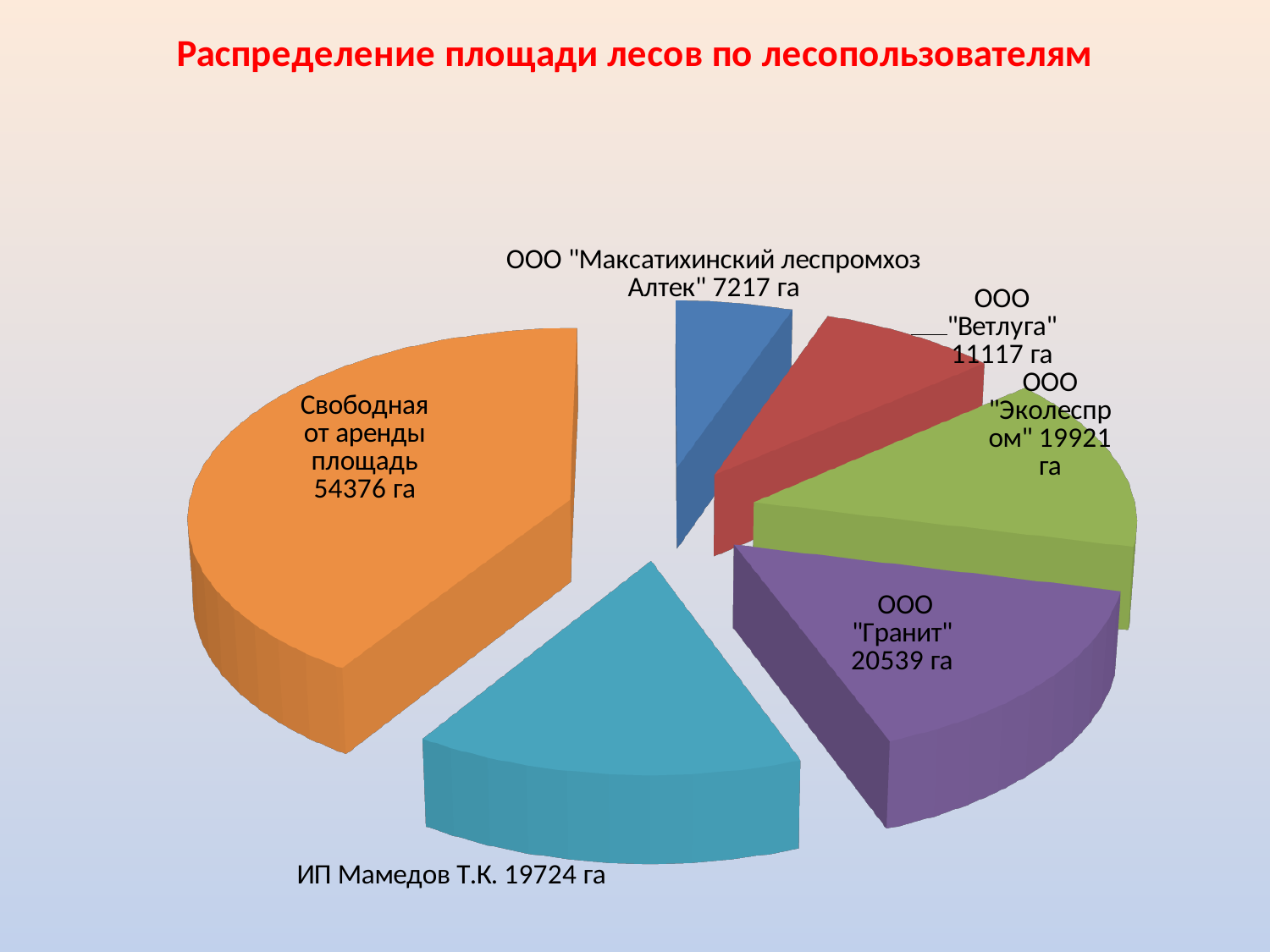
What is the area for ООО "Гранит"? 20539 га What is the title of the chart? Распределение площади лесов по лесопользователям What is the area for ИП Мамедов Т.К.? 19724 га How many slices does the pie chart have? 6 What colour is the slice for ООО "Эколеспром"? Green Which forest user has the smallest area? ООО "Максатихинский леспромхоз Алтек" Which slice has the largest area? Свободная от аренды площадь What is the area for ООО "Ветлуга"? 11117 га Which is larger, the area of ООО "Гранит" or the area of ИП Мамедов Т.К.? ООО "Гранит" What is the value of the slice labelled "Свободная от аренды площадь"? 54376 га What is the difference between the areas of ООО "Гранит" and ООО "Эколеспром"? 618 га What kind of chart is shown on the slide? Pie chart